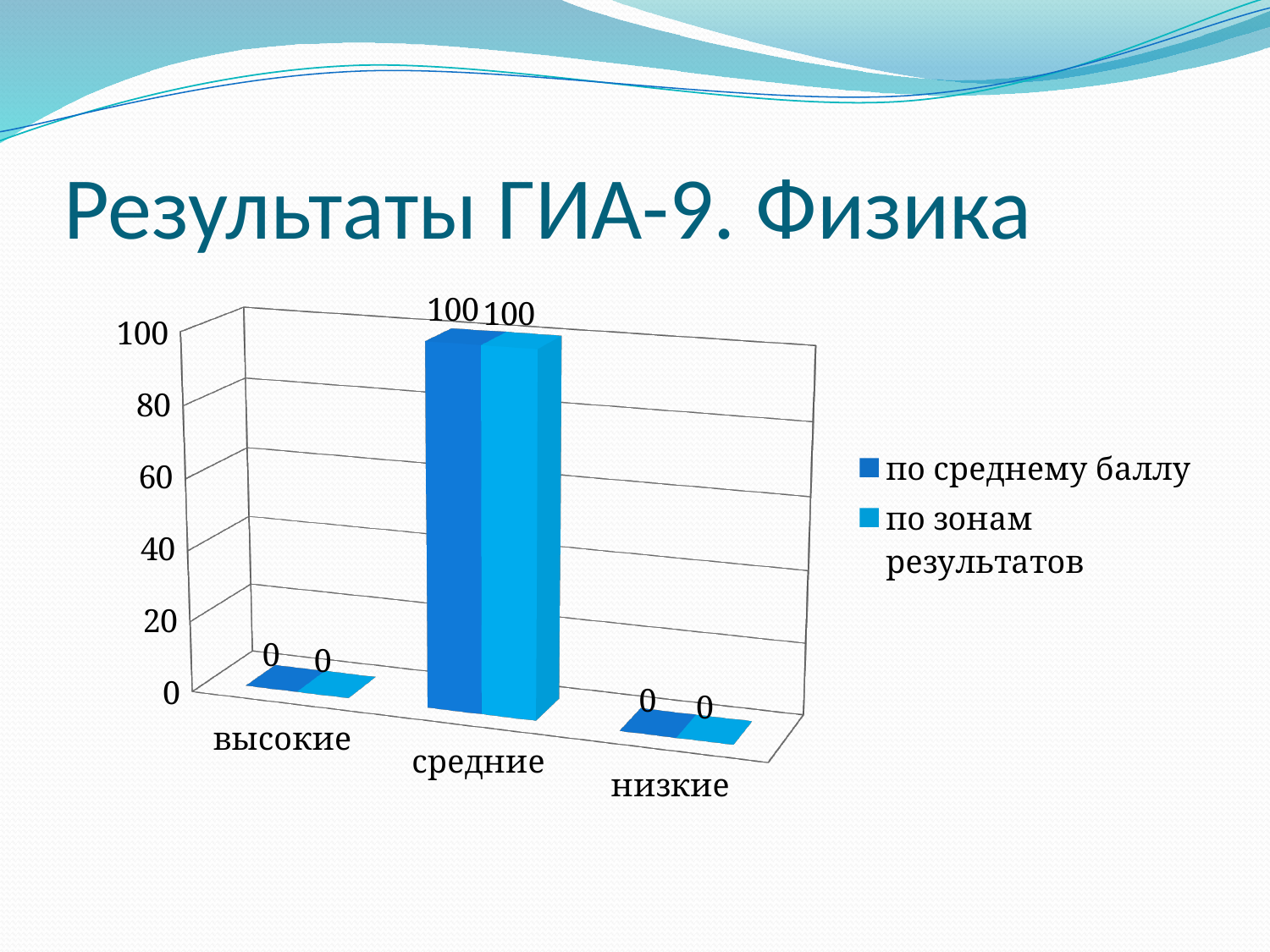
What is the highest value shown on the vertical axis? 100 What is the value for "высокие" in the "по зонам результатов" series? 0 What kind of chart is shown on the slide? bar chart What is the value for "низкие" in the "по среднему баллу" series? 0 Which category has the highest value in the "по зонам результатов" series? средние Which is larger in the "по зонам результатов" series: "средние" or "низкие"? средние What is the second series listed in the legend? по зонам результатов What is the value for "средние" in the "по среднему баллу" series? 100 How many series does the legend list? 2 What is the difference between the "средние" and "высокие" values in the "по среднему баллу" series? 100 What is the title of the slide? Результаты ГИА-9. Физика How many categories are shown on the x axis? 3